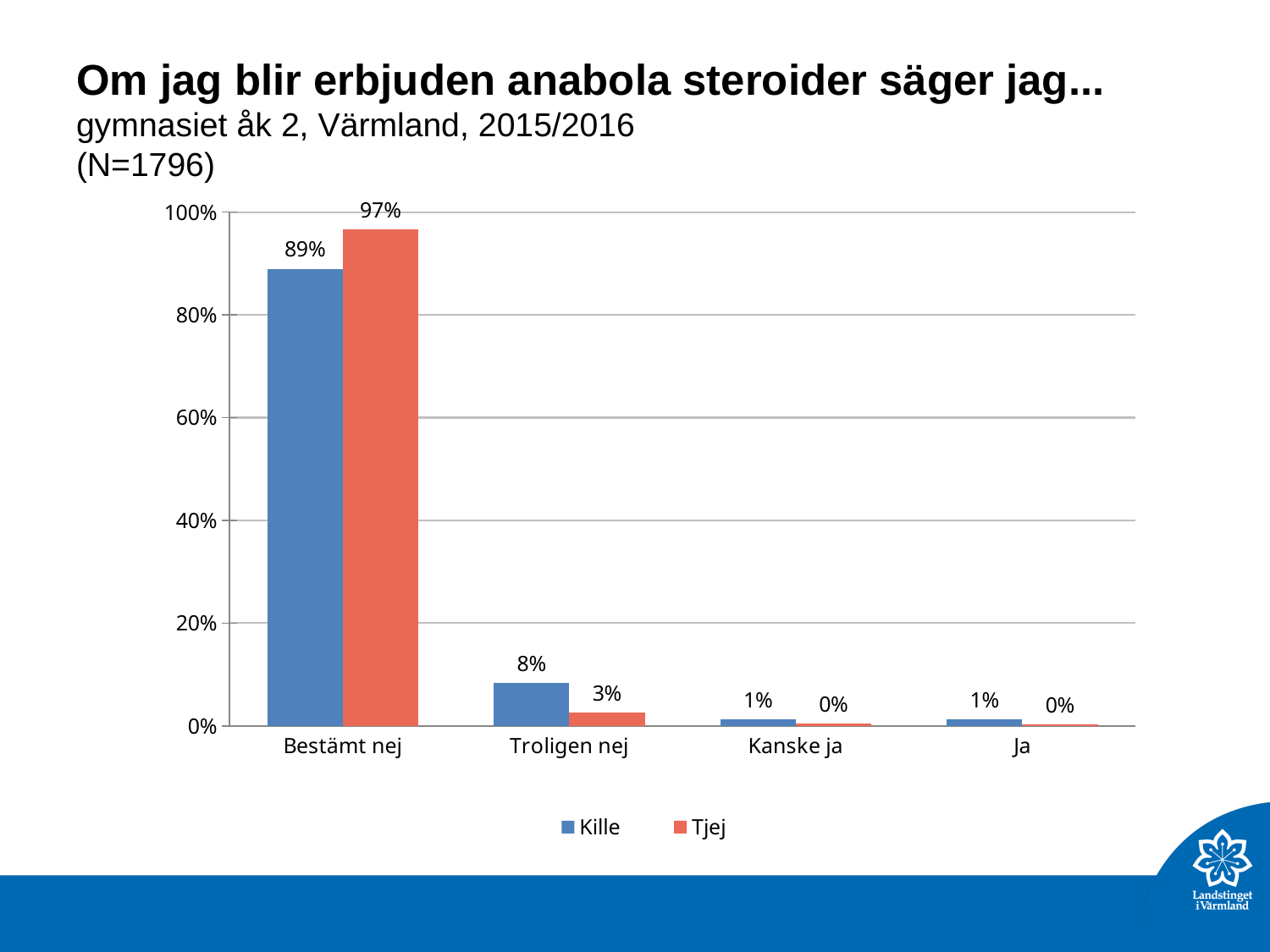
What is the value for Tjej in the Troligen nej category? 3% What is the difference between the Tjej and Kille values in the Bestämt nej category? 8% How many series does the legend list? 2 In the Troligen nej category, which series has the larger value, Kille or Tjej? Kille Which category has the highest value for Kille? Bestämt nej Is the value for Kille in the Bestämt nej category greater or less than 80%? greater What is the value for Kille in the Bestämt nej category? 89% How many categories are shown on the x axis? 4 What kind of chart is shown on the slide? bar chart What is the value for Tjej in the Bestämt nej category? 97% What is the value for Kille in the Troligen nej category? 8% What is the value for Tjej in the Kanske ja category? 0%